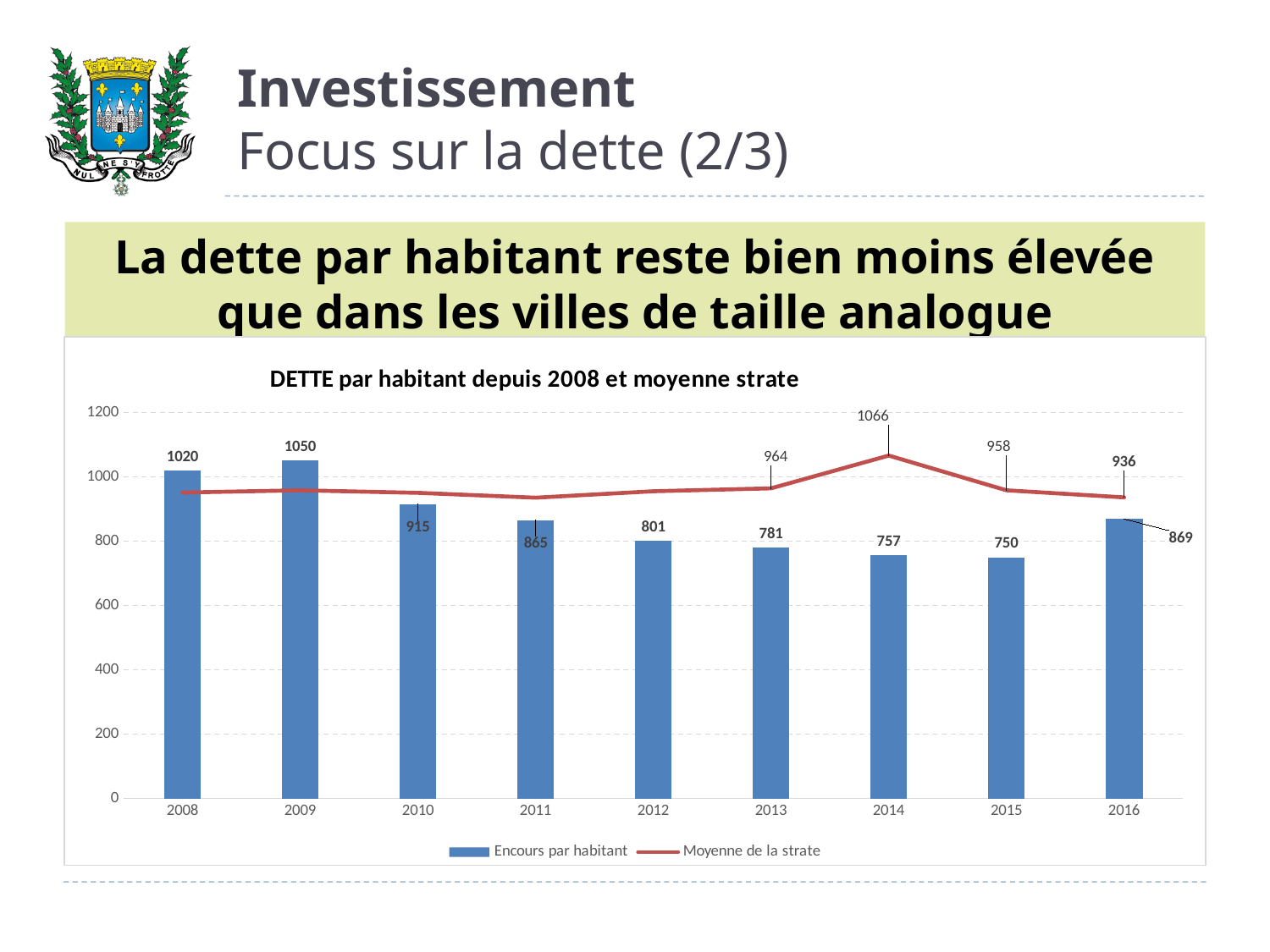
In which year is Encours par habitant the highest? 2009 What is the difference between Encours par habitant in 2009 and in 2015? 300 Does Encours par habitant rise or fall from 2009 to 2015? fall What is the value of Moyenne de la strate for 2014? 1066 What is the value of Encours par habitant for 2016? 869 In which year is Encours par habitant the lowest? 2015 How many series does the legend list? 2 What kind of chart is shown on the slide? A bar chart combined with a line chart How many years are shown on the x axis? 9 In 2016, which is larger: Encours par habitant or Moyenne de la strate? Moyenne de la strate Is the value of Moyenne de la strate for 2010 greater or less than 800? greater What is the value of Encours par habitant for 2009? 1050